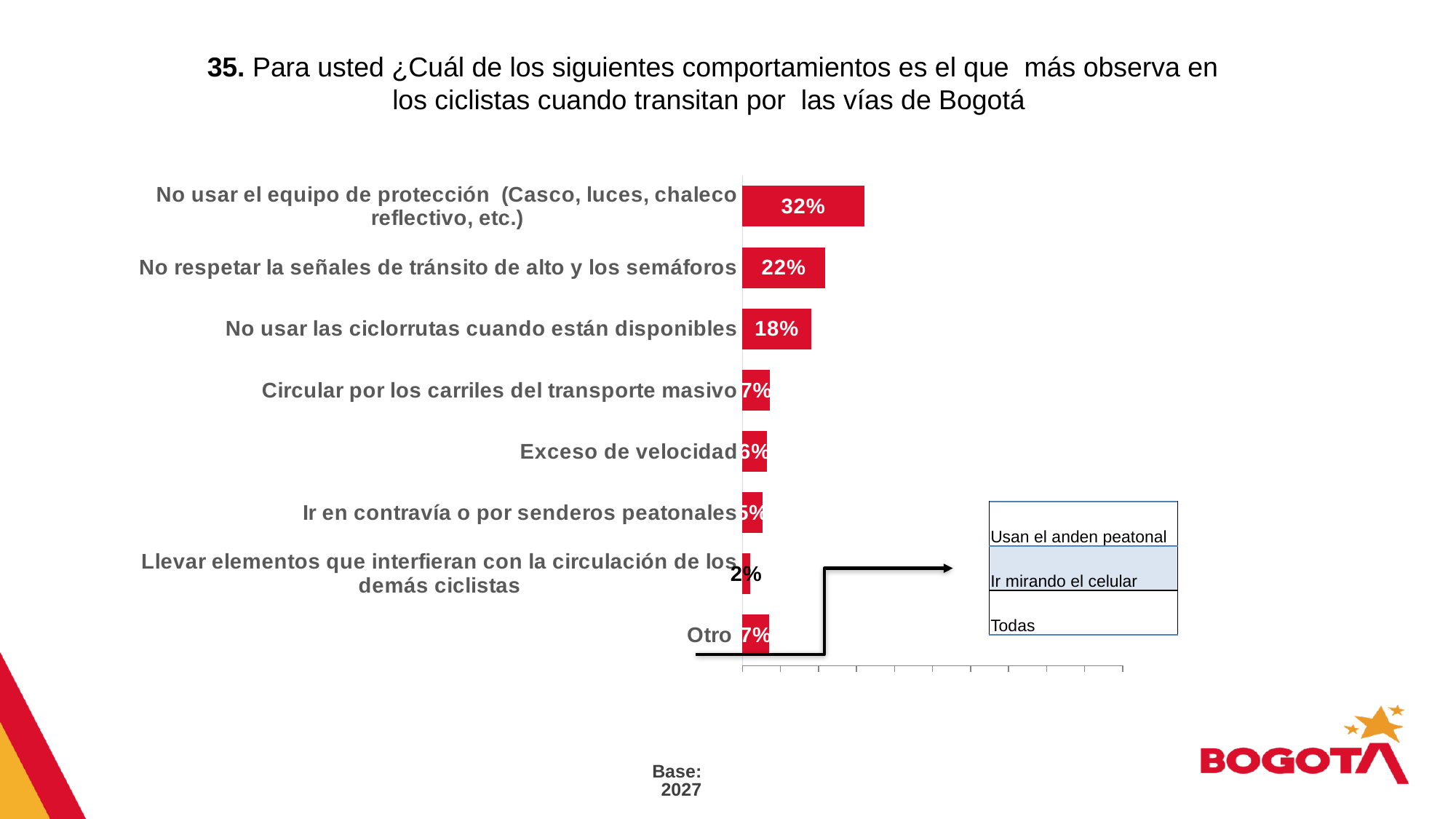
What percentage is shown for "No usar las ciclorrutas cuando están disponibles"? 18% What is the base (number of respondents) shown below the chart? 2027 Which is larger: the value for "No usar las ciclorrutas cuando están disponibles" or for "Circular por los carriles del transporte masivo"? No usar las ciclorrutas cuando están disponibles What percentage is shown for "No usar el equipo de protección (Casco, luces, chaleco reflectivo, etc.)"? 32% What value is shown for "Exceso de velocidad"? 6% What value is shown for "No respetar la señales de tránsito de alto y los semáforos"? 22% Which category has the highest value in the chart? No usar el equipo de protección (Casco, luces, chaleco reflectivo, etc.) What is the difference between the values for "No usar el equipo de protección" and "No respetar la señales de tránsito de alto y los semáforos"? 10% What percentage is shown for "Llevar elementos que interfieran con la circulación de los demás ciclistas"? 2% Which category has the lowest value in the chart? Llevar elementos que interfieran con la circulación de los demás ciclistas How many categories are plotted in the chart? 8 What type of chart is shown on the slide? Bar chart